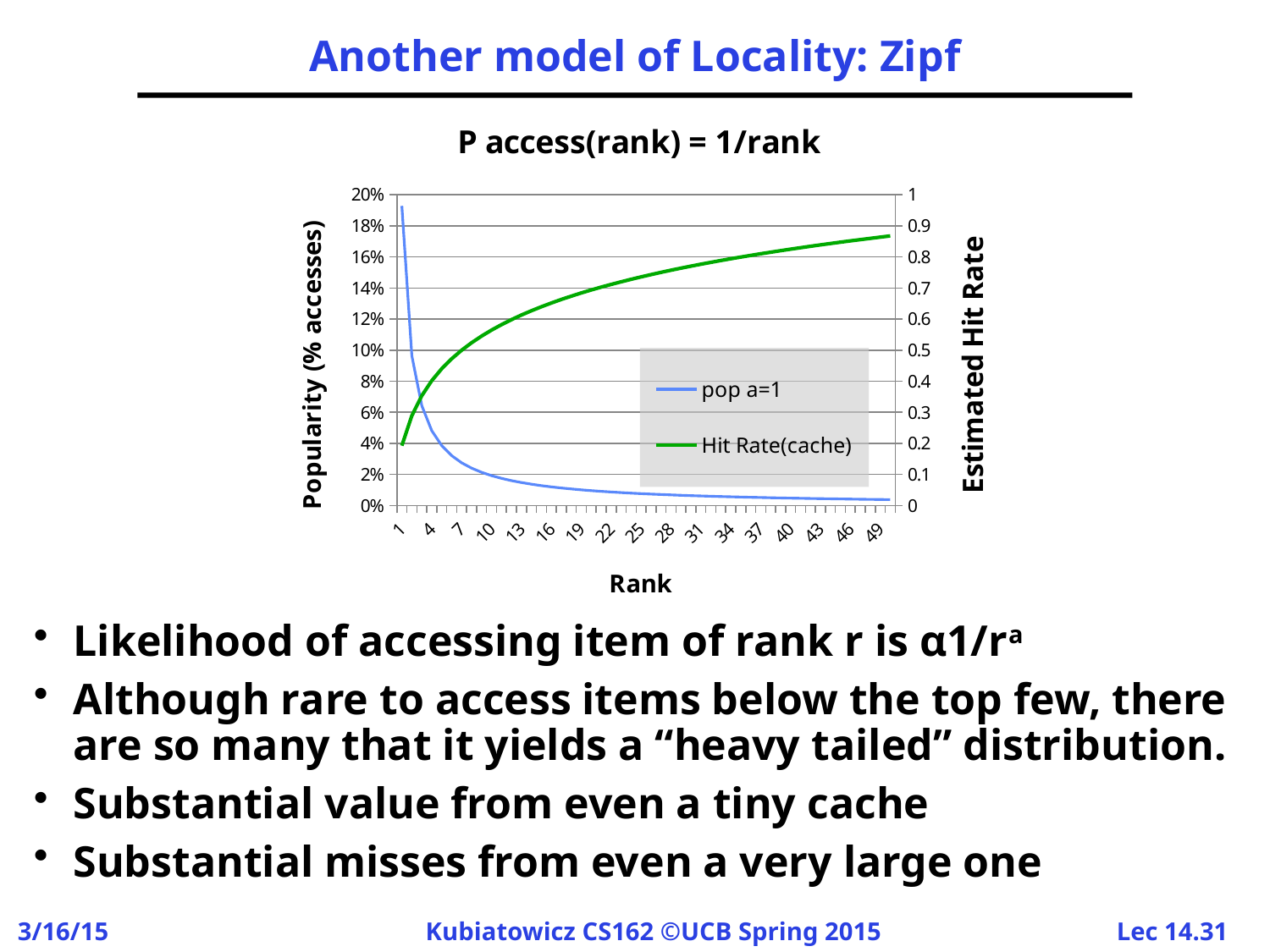
Is the 'Hit Rate(cache)' value at rank 49 greater or less than 0.8? greater Is the 'Hit Rate(cache)' value at rank 1 greater or less than 0.3? less What is the title of the chart? P access(rank) = 1/rank Is the 'pop a=1' value at rank 10 greater or less than 4%? less What kind of chart is shown on the slide? line chart Which series is higher at rank 49, 'pop a=1' (left axis) or 'Hit Rate(cache)' (right axis), relative to their own axes? Hit Rate(cache) How many series does the chart's legend list? 2 Does the 'pop a=1' series rise or fall as rank increases along the x axis? fall Does the 'Hit Rate(cache)' series rise or fall as rank increases along the x axis? rise What are the two series named in the chart's legend? pop a=1 and Hit Rate(cache)